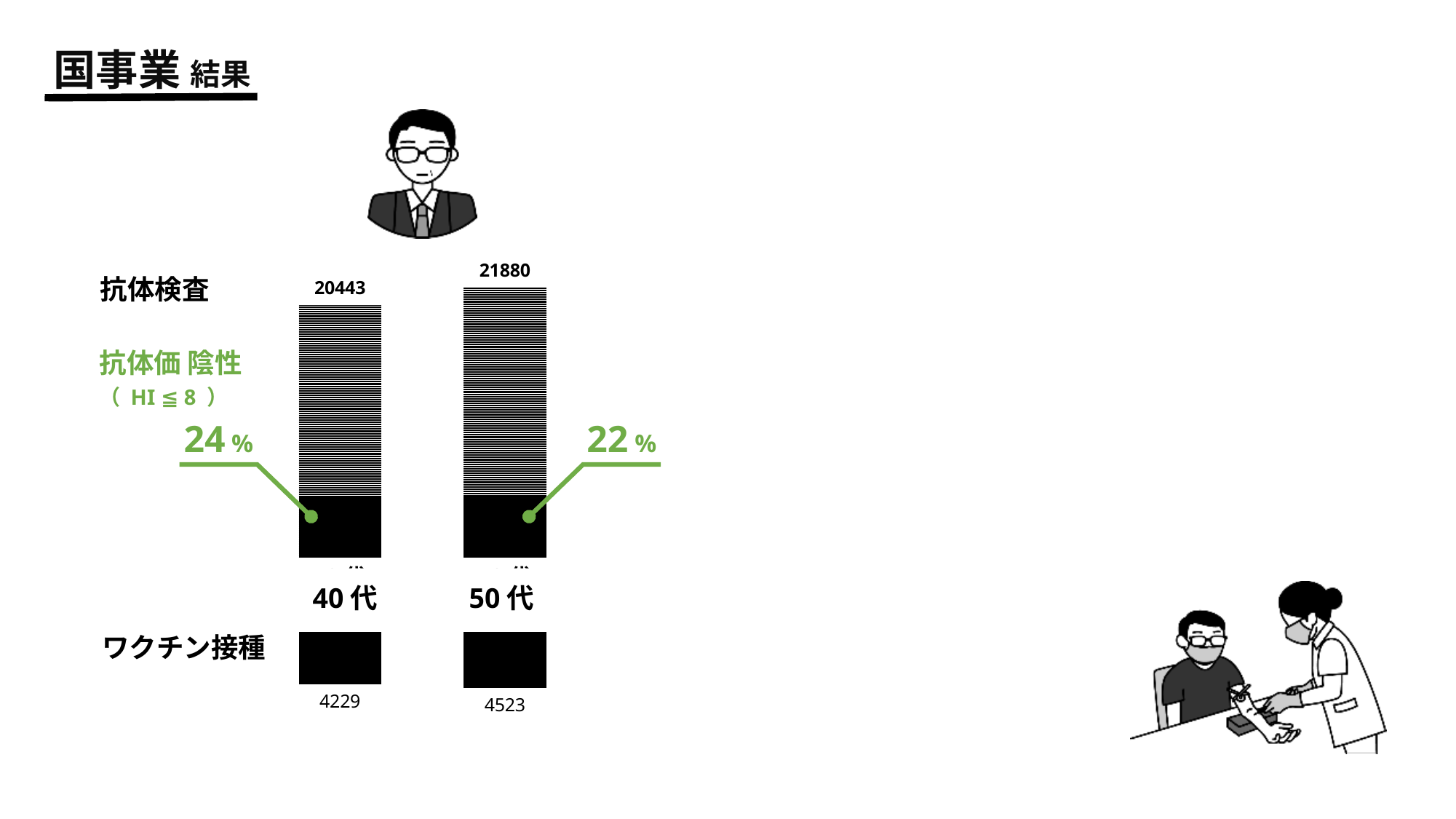
What is the difference between the ワクチン接種 values for 50代 and 40代? 294 What percentage of the 50代 bar is labelled as 抗体価 陰性 (HI ≦ 8)? 22 % What is the 抗体検査 value printed above the bar for 50代? 21880 What kind of chart is shown on the slide? bar chart Which age group has the higher 抗体価 陰性 percentage, 40代 or 50代? 40代 How many age-group categories are shown in the chart? 2 What is the ワクチン接種 value printed below the bar for 40代? 4229 What is the 抗体検査 value printed above the bar for 40代? 20443 Which age group has the higher 抗体検査 value, 40代 or 50代? 50代 What percentage of the 40代 bar is labelled as 抗体価 陰性 (HI ≦ 8)? 24 % What is the ワクチン接種 value printed below the bar for 50代? 4523 What is the difference between the 抗体検査 values for 50代 and 40代? 1437